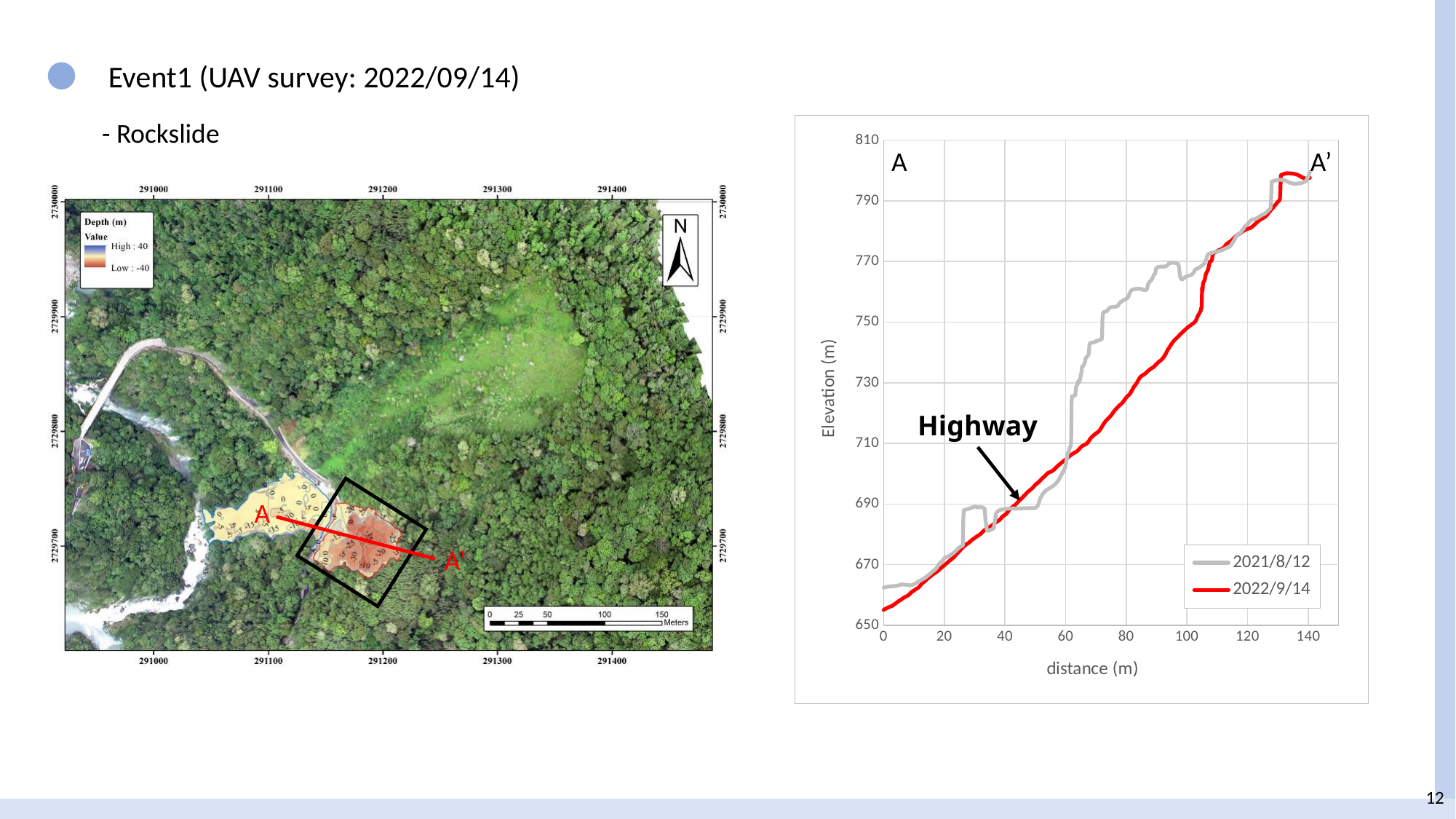
In the elevation chart, at a distance of 80 m, is the 2021/8/12 elevation greater or less than 750? greater What kind of chart is shown on the right side of the slide? line chart In the elevation chart, at a distance of 80 m, which series shows the higher elevation, 2021/8/12 or 2022/9/14? 2021/8/12 In the elevation chart, which series is drawn in red? 2022/9/14 In the elevation chart, at a distance of 0 m, is the 2022/9/14 elevation greater or less than 670? less In the elevation chart, at a distance of 100 m, is the 2022/9/14 elevation greater or less than 770? less In the elevation chart, does elevation generally rise or fall as distance increases from A to A'? rise How many series does the legend of the elevation chart list? 2 In the elevation chart, what are the two series named in the legend? 2021/8/12 and 2022/9/14 In the elevation chart, what is the label of the y axis? Elevation (m)